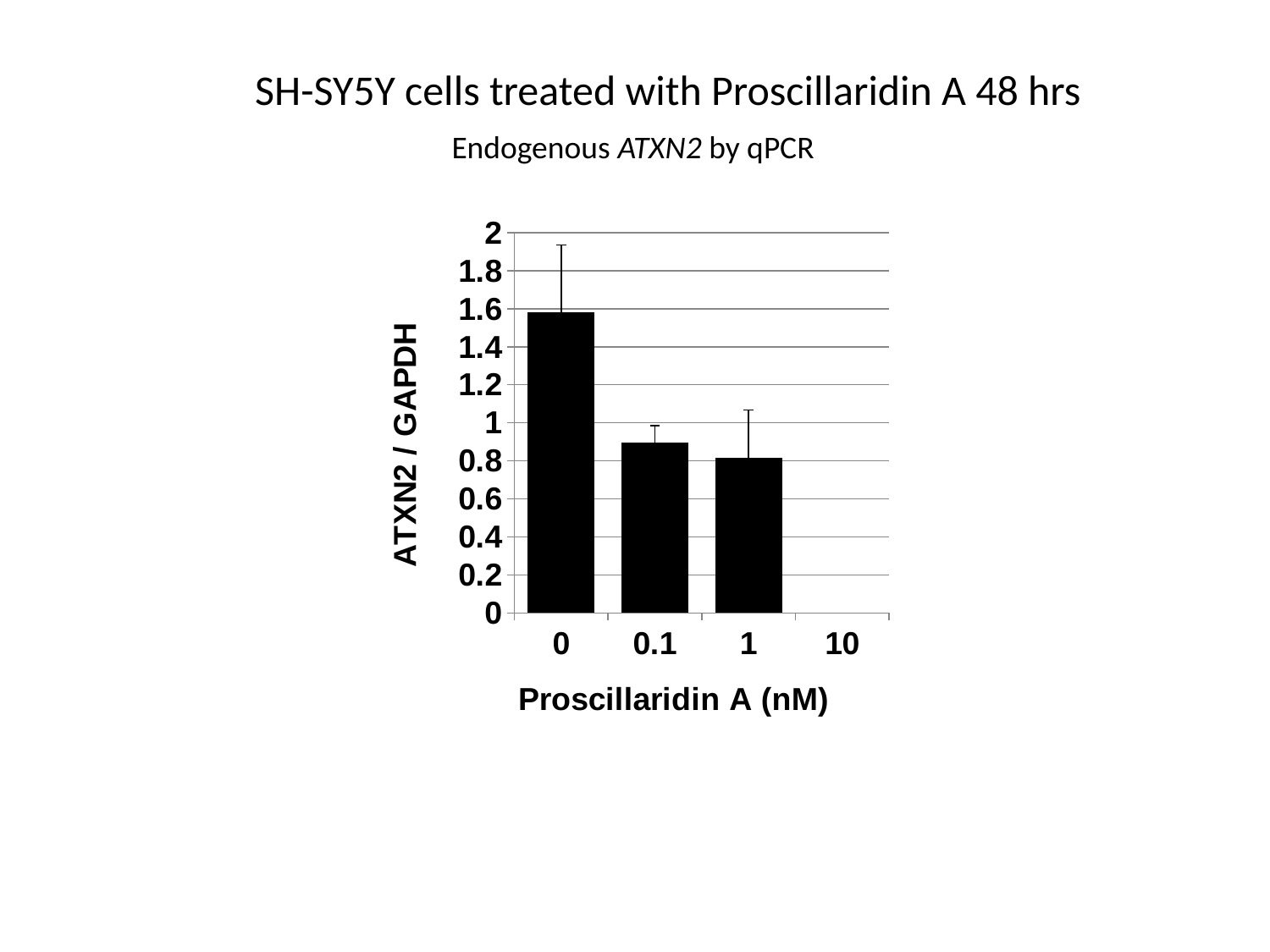
Do the ATXN2 / GAPDH values rise or fall as the Proscillaridin A concentration increases along the x axis? fall Is the ATXN2 / GAPDH value for 0.1 nM Proscillaridin A greater or less than 1? less Is the ATXN2 / GAPDH value for 1 nM Proscillaridin A greater or less than 1? less What is the label of the x axis? Proscillaridin A (nM) Which Proscillaridin A concentration has the highest ATXN2 / GAPDH value? 0 Which has the larger ATXN2 / GAPDH value, 0 nM or 1 nM Proscillaridin A? 0 nM What is the label of the y axis? ATXN2 / GAPDH Is the ATXN2 / GAPDH value for 0 nM Proscillaridin A greater or less than 1.8? less What kind of chart is shown on the slide? bar chart How many Proscillaridin A concentrations are labelled on the x axis? 4